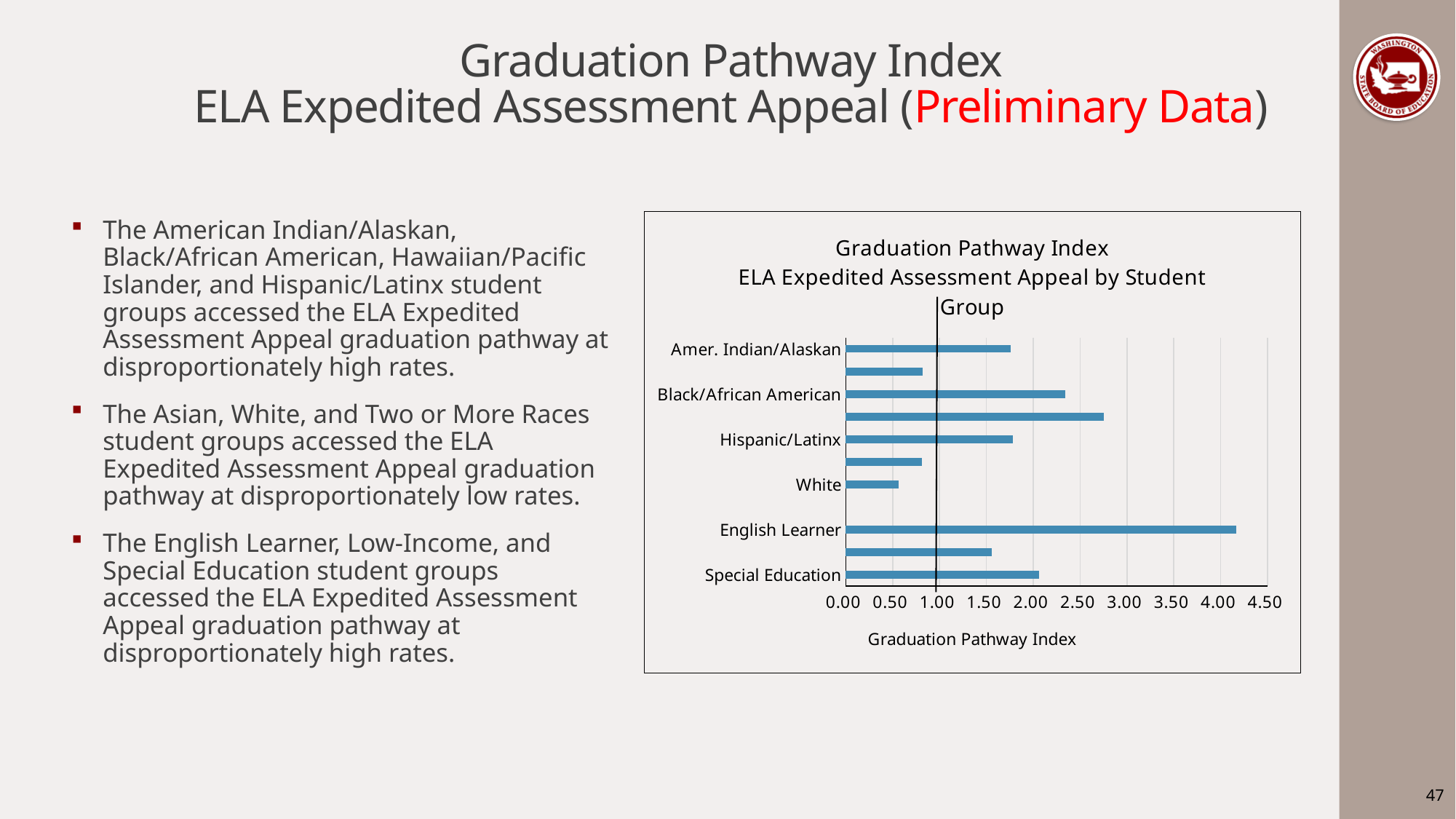
What is the title of the horizontal axis of the chart? Graduation Pathway Index Among the labeled student groups, which has the lowest Graduation Pathway Index? White Which has a larger Graduation Pathway Index, Black/African American or White? Black/African American Is the Graduation Pathway Index for Special Education greater or less than 1.50? greater Is the Graduation Pathway Index for Hispanic/Latinx greater or less than 1.00? greater Is the Graduation Pathway Index for English Learner greater or less than 4.00? greater Which has a larger Graduation Pathway Index, English Learner or Special Education? English Learner Among the labeled student groups, which has the highest Graduation Pathway Index? English Learner What type of chart is shown on the slide? bar chart